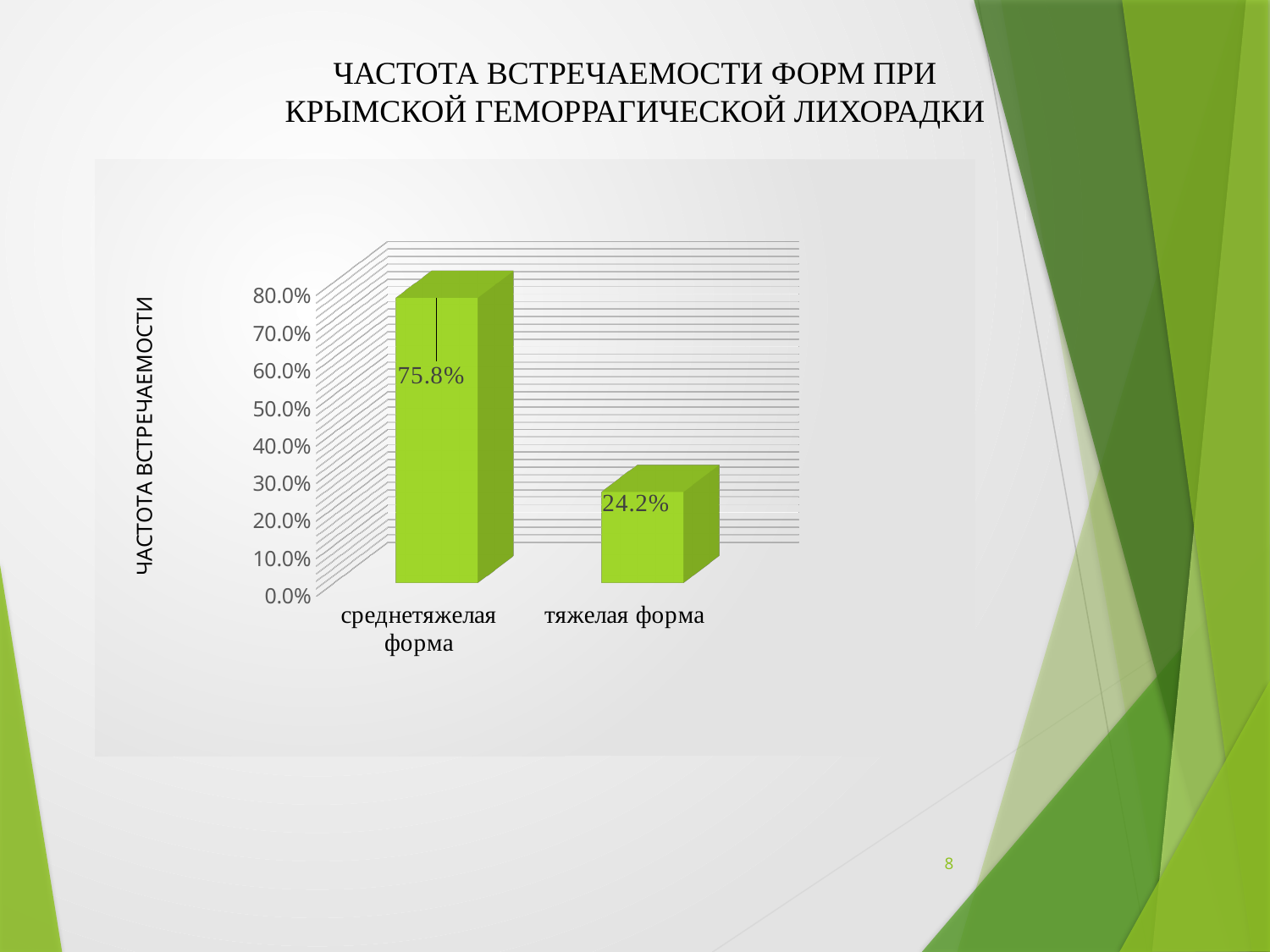
What is the label of the vertical axis? ЧАСТОТА ВСТРЕЧАЕМОСТИ Which is larger, the value for среднетяжелая форма or the value for тяжелая форма? среднетяжелая форма How many categories are shown on the x axis? 2 Is the value for тяжелая форма greater or less than 30.0%? less What kind of chart is shown on the slide? bar chart What is the value for среднетяжелая форма? 75.8% Which category has the highest value? среднетяжелая форма Which category has the lowest value? тяжелая форма Is the value for среднетяжелая форма greater or less than 70.0%? greater What is the title of the slide? ЧАСТОТА ВСТРЕЧАЕМОСТИ ФОРМ ПРИ КРЫМСКОЙ ГЕМОРРАГИЧЕСКОЙ ЛИХОРАДКИ What is the value for тяжелая форма? 24.2% What is the difference between the values for среднетяжелая форма and тяжелая форма? 51.6%